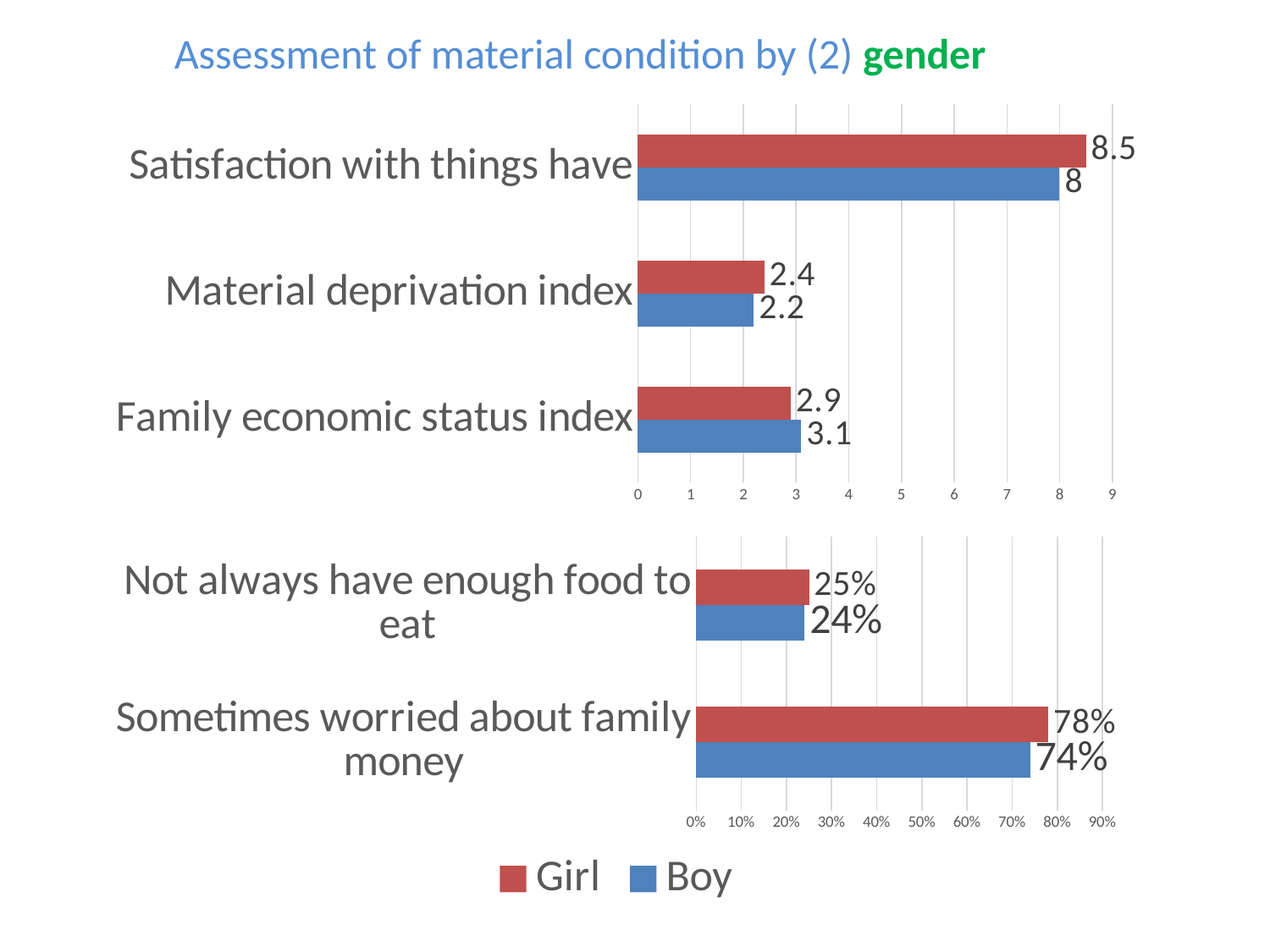
In the bottom chart, what is the value for Boy on Sometimes worried about family money? 74% In the top chart, what is the difference between the Girl and Boy values for Satisfaction with things have? 0.5 In the bottom chart, what is the value for Girl on Not always have enough food to eat? 25% How many series does the legend list? 2 In the top chart, what is the value for Girl on Satisfaction with things have? 8.5 In the top chart, what is the value for Boy on Material deprivation index? 2.2 What kind of chart is the top chart? Bar chart In the top chart, which category has the lowest value for Girl? Material deprivation index In the top chart, which is larger for Family economic status index, the Girl value or the Boy value? Boy How many categories does the bottom chart show? 2 In the bottom chart, what is the difference between the Girl and Boy values for Sometimes worried about family money? 4% In the top chart, which category has the highest value for Boy? Satisfaction with things have